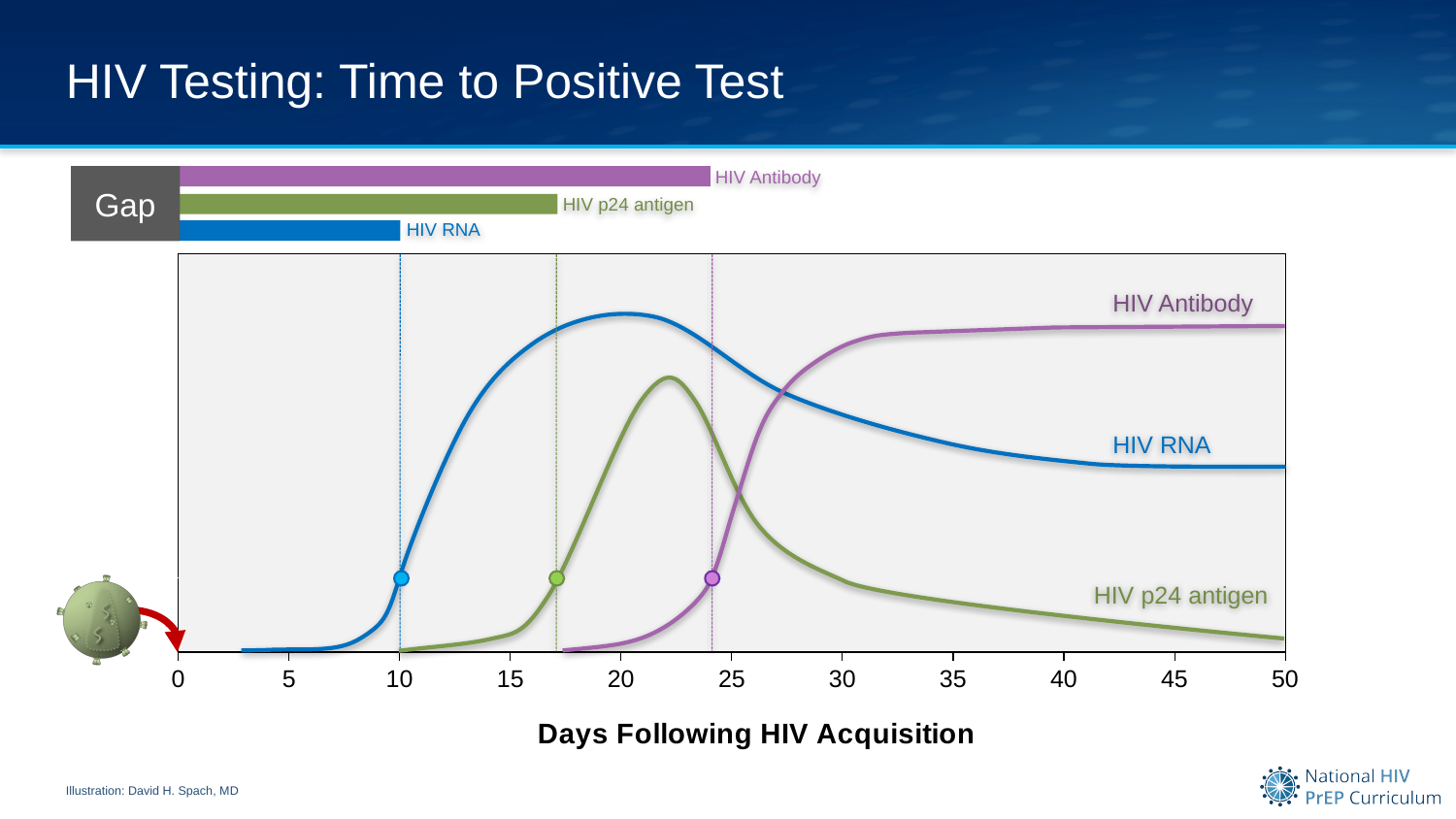
Which curve is highest at day 50? HIV Antibody At how many days does the HIV RNA curve reach its marked time-to-positive point? 10 Which curve reaches its marked time-to-positive point last? HIV Antibody What is the highest value shown on the x axis? 50 Does the HIV Antibody curve rise or fall between day 25 and day 50? rise How many curves (series) are plotted on the chart? 3 What kind of chart is shown on the slide? line chart What is the label of the x axis? Days Following HIV Acquisition Is the marked time-to-positive point for HIV Antibody greater or less than 20 days? greater Which curve reaches its marked time-to-positive point first? HIV RNA Is the marked time-to-positive point for HIV p24 antigen greater or less than 15 days? greater Which curve is lowest at day 50? HIV p24 antigen